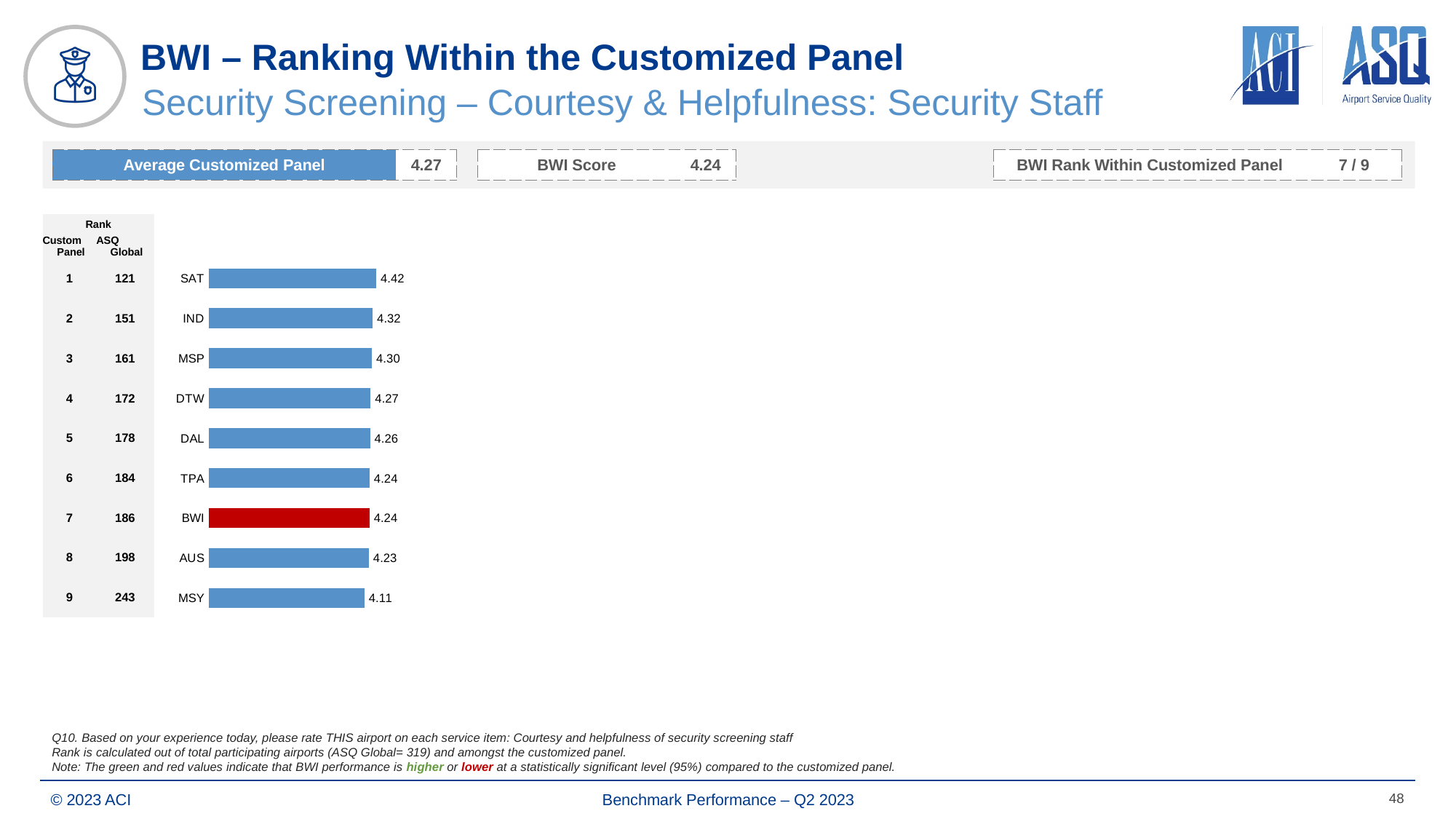
What kind of chart is shown on the slide? bar chart What is the difference between the values for SAT and MSY? 0.31 Which is larger, the value for MSP or the value for DAL? MSP What is the value for DTW? 4.27 What is the difference between the values for IND and AUS? 0.09 How many airports are shown in the bar chart? 9 What is the value for BWI? 4.24 Which airport's bar is coloured red? BWI What is the value for SAT? 4.42 Which airport has the highest value? SAT Which airport has the lowest value? MSY What is the value for MSY? 4.11